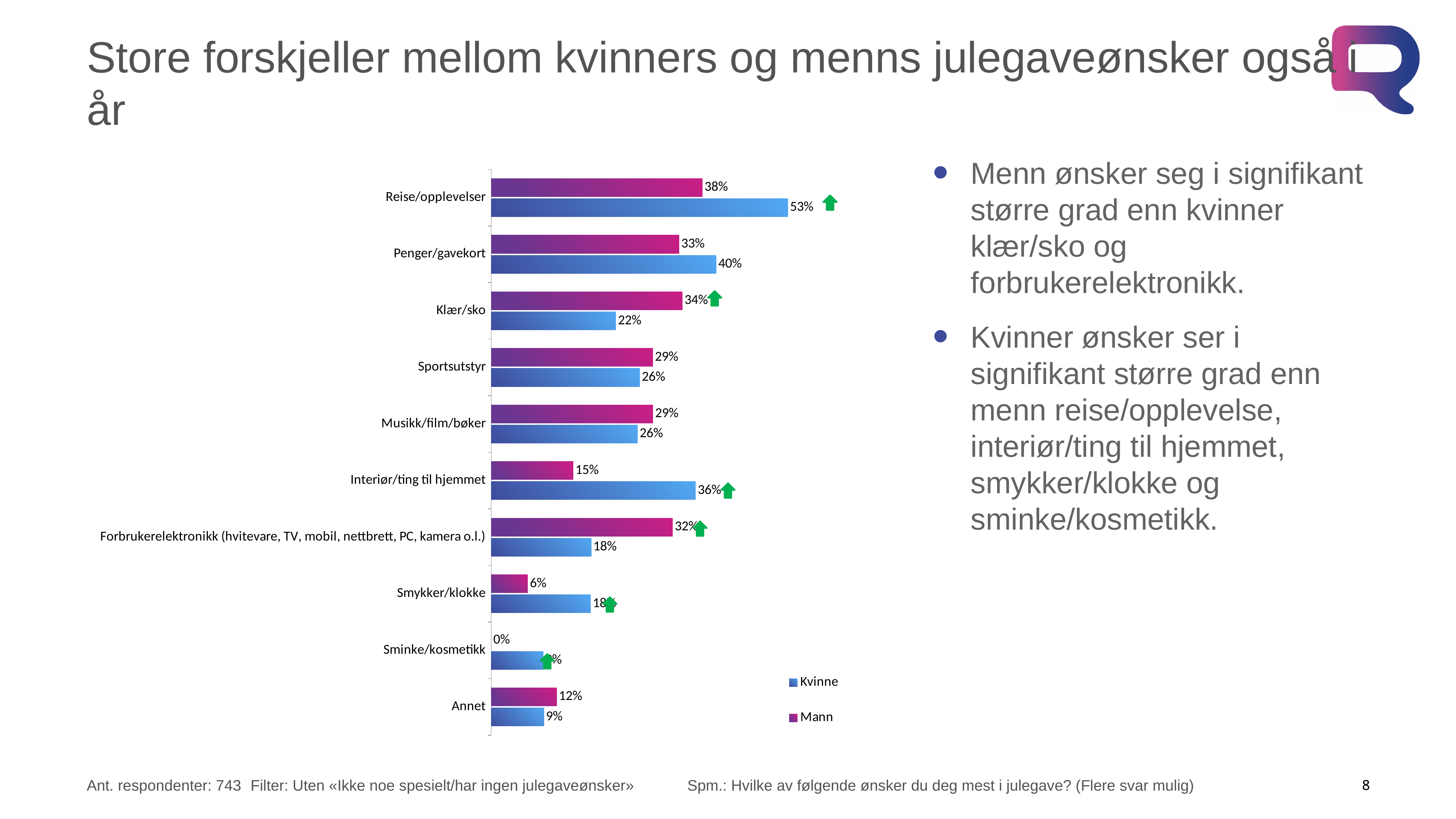
What is the value for Kvinne in the Reise/opplevelser category? 53% How many categories are shown on the chart? 10 How many series does the chart legend list? 2 What is the value for Mann in the Klær/sko category? 34% Which category has the highest value for Kvinne? Reise/opplevelser In the Forbrukerelektronikk category, which series has the larger value, Kvinne or Mann? Mann What is the value for Kvinne in the Penger/gavekort category? 40% What kind of chart is shown on the slide? Bar chart Which category has the lowest value for Mann? Sminke/kosmetikk What are the two entries in the chart legend? Kvinne and Mann What is the difference between the Kvinne and Mann values for Reise/opplevelser? 15 percentage points What is the value for Mann in the Interiør/ting til hjemmet category? 15%